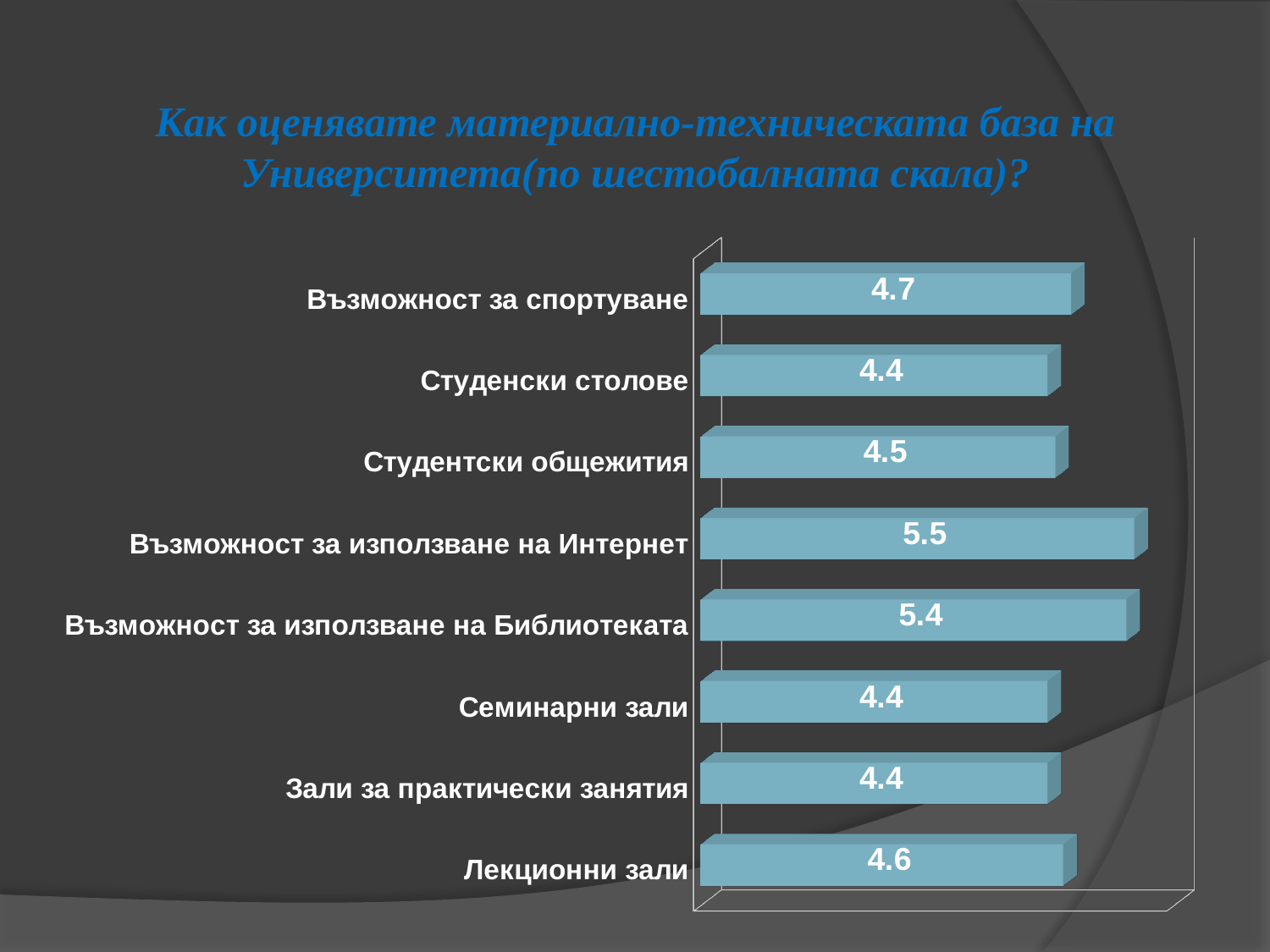
Which category has the highest value? Възможност за използване на Интернет What is the title of the slide? Как оценявате материално-техническата база на Университета(по шестобалната скала)? What is the difference between the values for Възможност за спортуване and Лекционни зали? 0.1 How many categories are shown on the chart? 8 What kind of chart is shown on the slide? bar chart What is the value for Студентски общежития? 4.5 What is the lowest value shown on the chart? 4.4 What is the value for Възможност за спортуване? 4.7 Which is larger, the value for Възможност за използване на Интернет or the value for Възможност за използване на Библиотеката? Възможност за използване на Интернет What is the value for Възможност за използване на Интернет? 5.5 What is the difference between the values for Възможност за използване на Интернет and Семинарни зали? 1.1 What is the value for Лекционни зали? 4.6